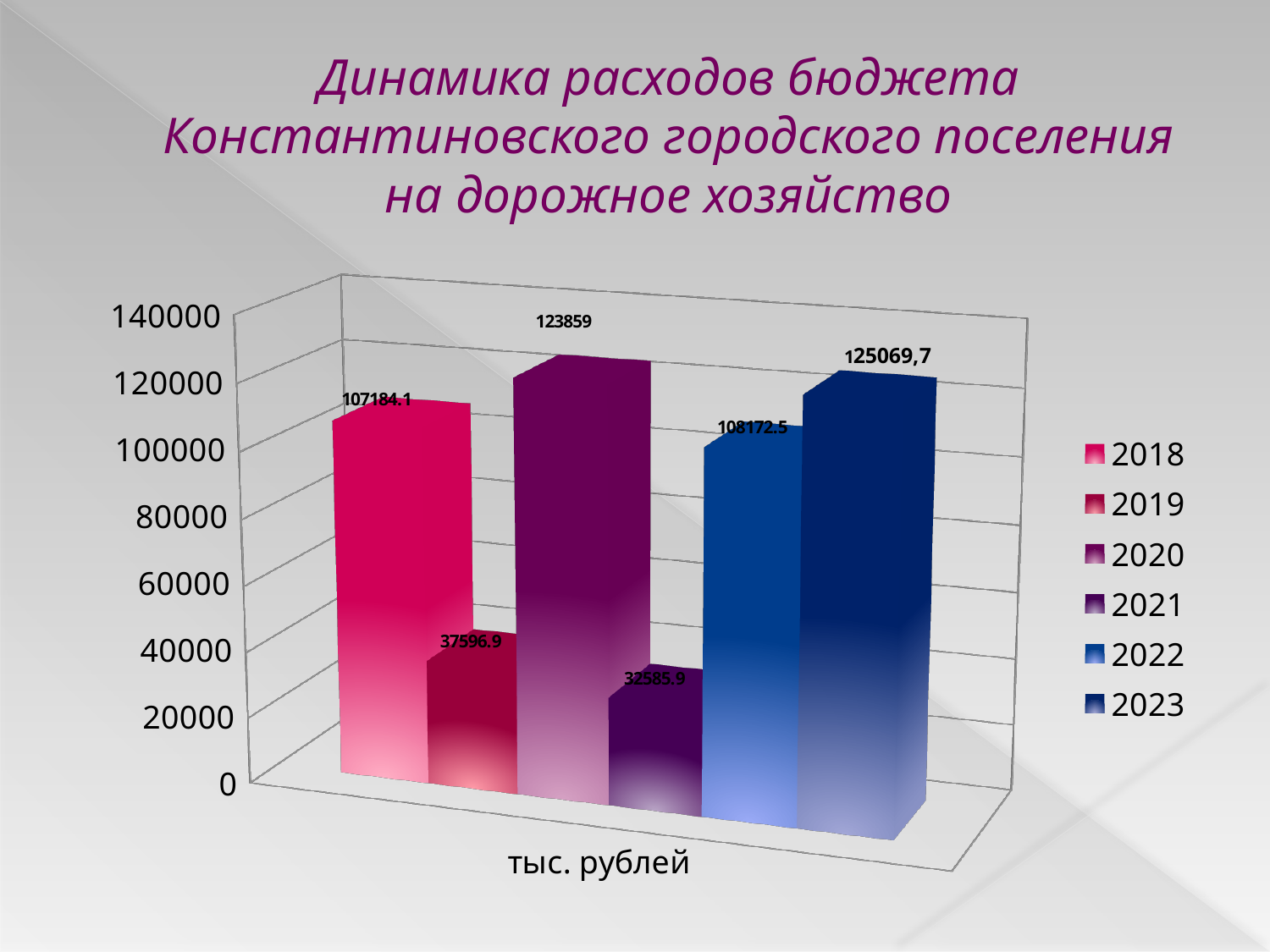
What is the value for 2021? 32585.9 Which is larger, the value for 2019 or the value for 2022? 2022 Is the value for 2018 greater or less than 100000? greater What kind of chart is shown on the slide? bar chart What is the value for 2023? 125069,7 Which year has the highest value? 2023 What is the value for 2018? 107184.1 Which year has the lowest value? 2021 What is the value for 2020? 123859 How many series does the legend list? 6 What is the difference between the values for 2019 and 2021? 5011 What unit label is shown below the chart? тыс. рублей